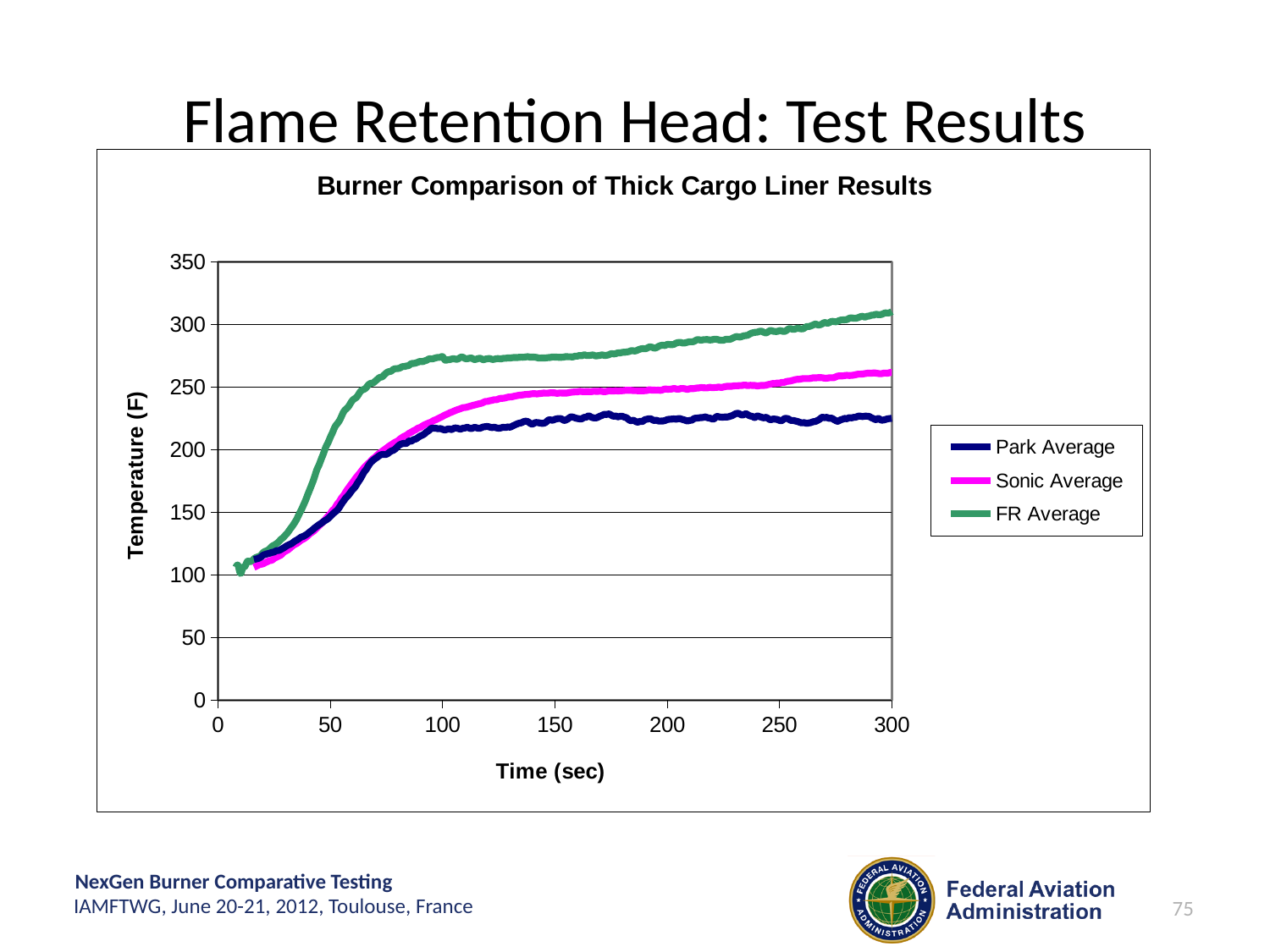
Do the temperatures generally rise or fall as time increases from 0 to 300 seconds? rise Which series has the highest temperature at 300 seconds? FR Average Is the value for Park Average at 300 seconds greater or less than 250? less At 100 seconds, which is higher: FR Average or Park Average? FR Average What is the title of the chart? Burner Comparison of Thick Cargo Liner Results Is the value for Sonic Average at 100 seconds greater or less than 200? greater Which series has the lowest temperature at 300 seconds? Park Average Is the value for FR Average at 50 seconds greater or less than 150? greater How many series does the legend list? 3 What kind of chart is shown on the slide? line chart What is the label of the vertical axis? Temperature (F)